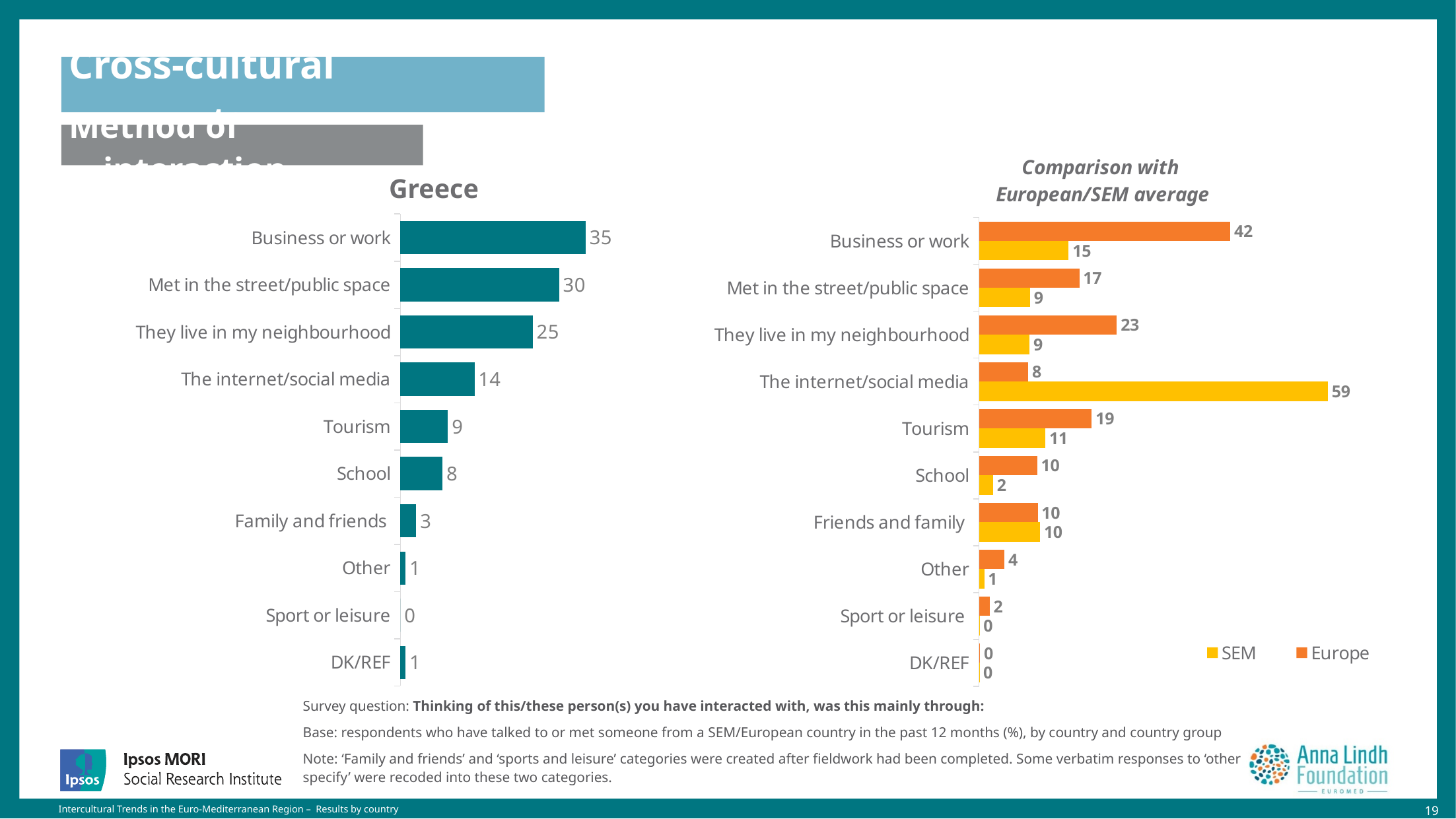
In the Comparison with European/SEM average chart, what is the Europe value for Business or work? 42 In the Greece chart, what is the value for Sport or leisure? 0 In the Comparison with European/SEM average chart, which is larger for Tourism, the SEM value or the Europe value? Europe In the Comparison with European/SEM average chart, how many series does the legend list? 2 In the Comparison with European/SEM average chart, what is the SEM value for The internet/social media? 59 In the Comparison with European/SEM average chart, what is the difference between the Europe and SEM values for They live in my neighbourhood? 14 In the Comparison with European/SEM average chart, which colour represents SEM? Yellow What kind of chart is the Greece chart? Bar chart In the Greece chart, how many categories are shown? 10 In the Greece chart, what is the value for Business or work? 35 In the Greece chart, which category has the highest value? Business or work In the Greece chart, what is the difference between Met in the street/public space and They live in my neighbourhood? 5